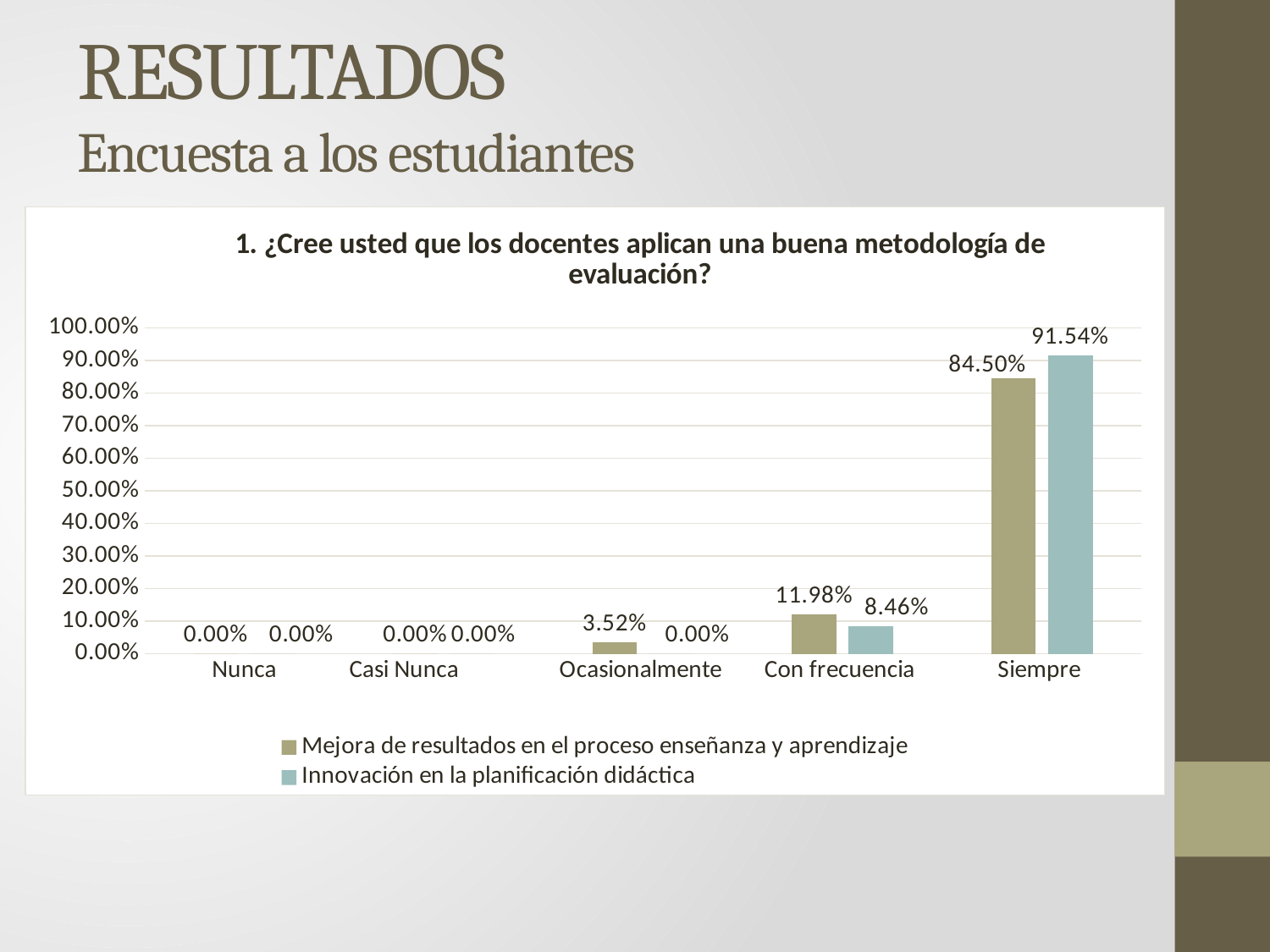
How many series does the legend list? 2 Which category has the highest value in the series 'Mejora de resultados en el proceso enseñanza y aprendizaje'? Siempre Do the values for the series 'Innovación en la planificación didáctica' generally rise or fall from Nunca to Siempre? Rise What kind of chart is shown on the slide? Bar chart How many categories are shown on the x axis? 5 What is the value for Con frecuencia in the series 'Mejora de resultados en el proceso enseñanza y aprendizaje'? 11.98% Is the value for Siempre in the series 'Mejora de resultados en el proceso enseñanza y aprendizaje' greater or less than 80.00%? greater What is the difference between the two series' values for Con frecuencia? 3.52% What is the value for Ocasionalmente in the series 'Mejora de resultados en el proceso enseñanza y aprendizaje'? 3.52% What is the value for Siempre in the series 'Innovación en la planificación didáctica'? 91.54% What is the difference between the two series' values for Siempre? 7.04% For Con frecuencia, which series has the larger value? Mejora de resultados en el proceso enseñanza y aprendizaje